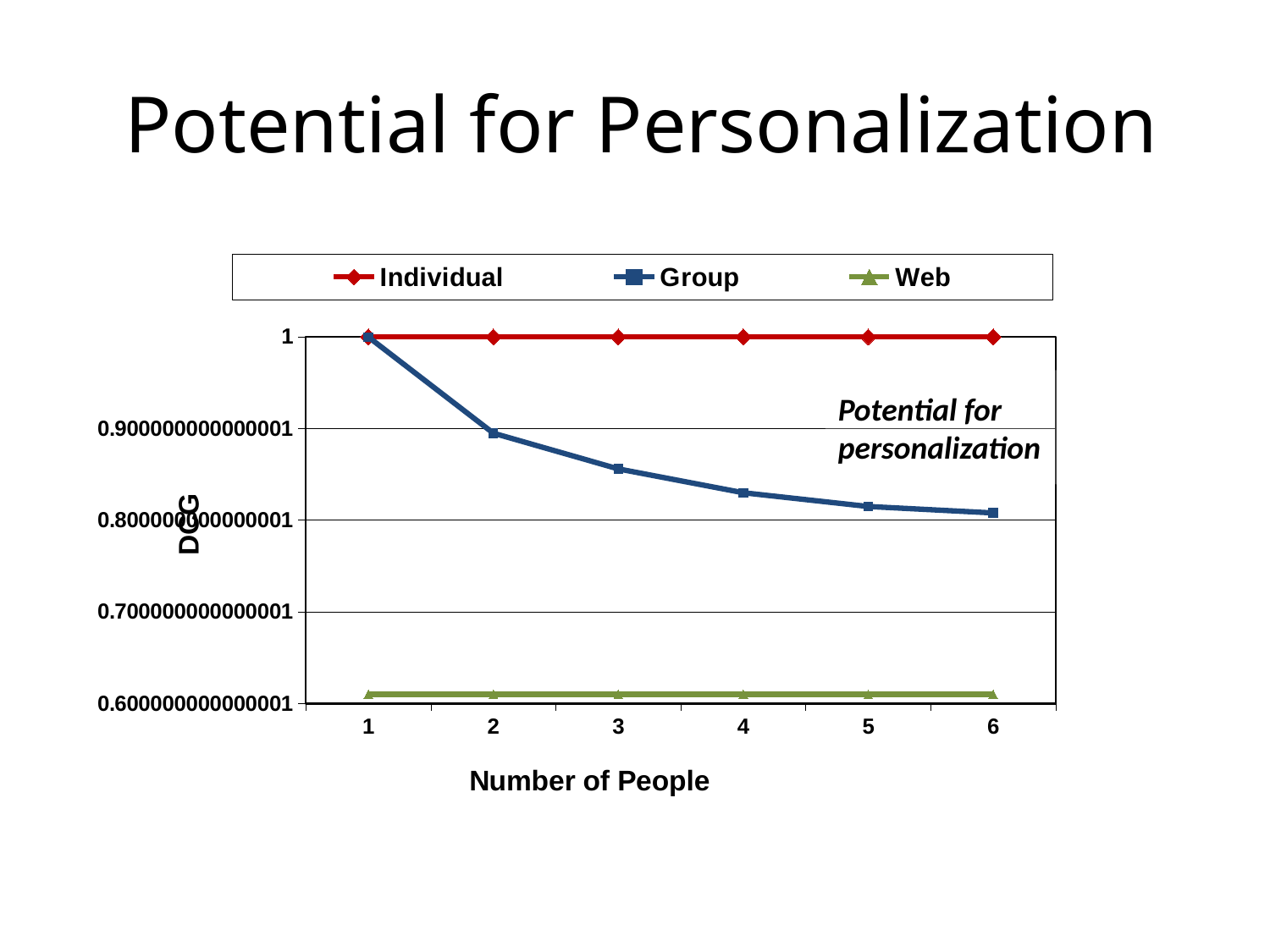
Is the DCG value for Group at 6 people greater or less than 0.9? less What is the DCG value for Individual when the number of people is 1? 1 Is the DCG value for Group at 2 people greater or less than 0.8? greater What is the title of the x axis? Number of People What kind of chart is shown on the slide? Line chart How many points along the x axis (Number of People) does each series have? 6 At 4 people, which series has the larger DCG value, Group or Web? Group What is the DCG value for Group when the number of people is 1? 1 How many series does the legend list? 3 Does the Group series rise or fall as the number of people increases? Fall Which series has the lowest DCG value at 6 people? Web Is the DCG value for Web at 3 people greater or less than 0.7? less